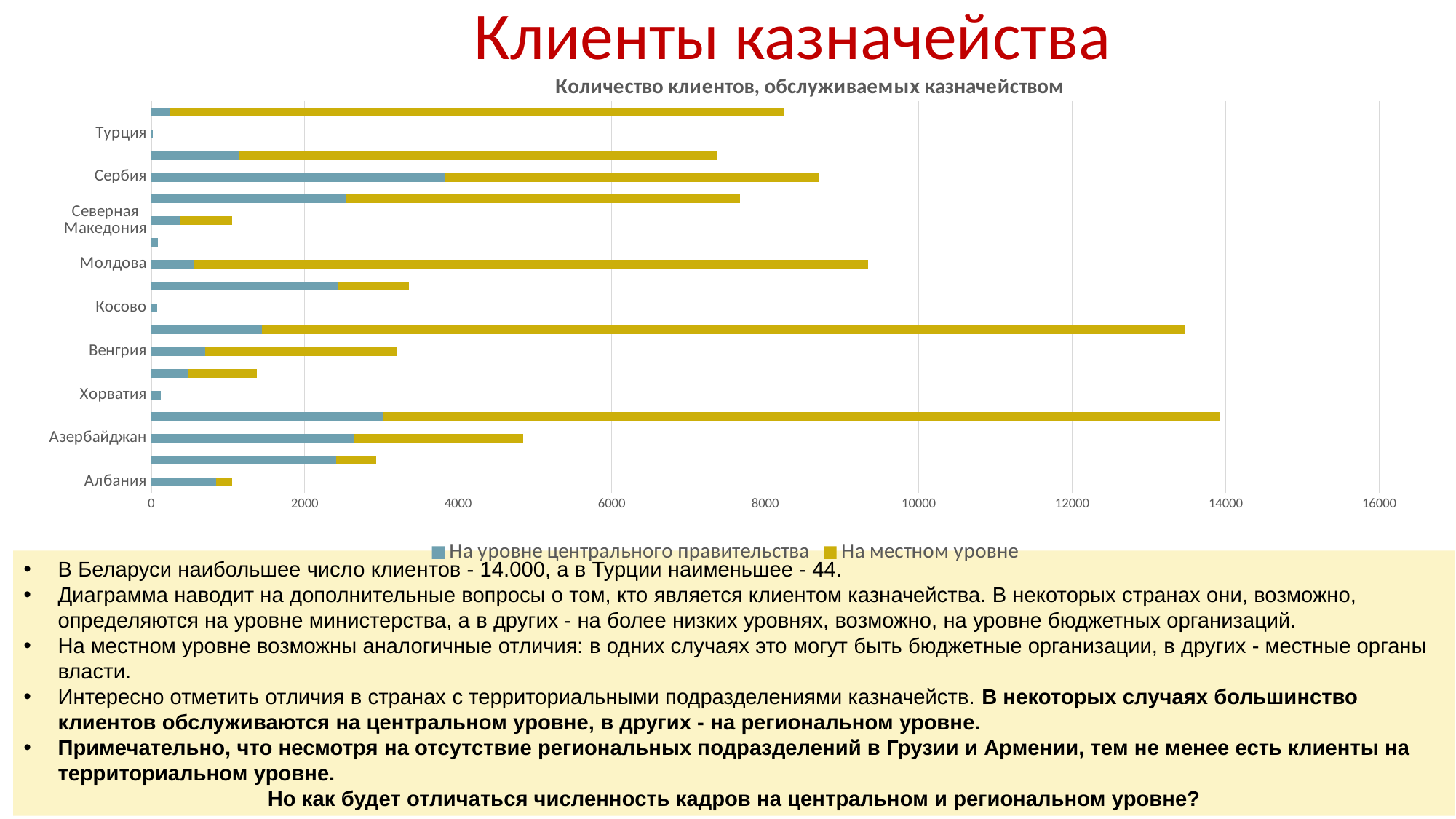
Is the total value for Албания greater or less than 2000? less Which has the larger total bar, Азербайджан or Венгрия? Азербайджан Is the total value for Сербия greater or less than 8000? greater Which series is shown in yellow in the chart? На местном уровне Which has the larger total bar, Сербия or Косово? Сербия What is the title of the chart? Количество клиентов, обслуживаемых казначейством What kind of chart is shown on the slide? Stacked bar chart How many series does the legend list? 2 Is the total value for Молдова greater or less than 8000? greater